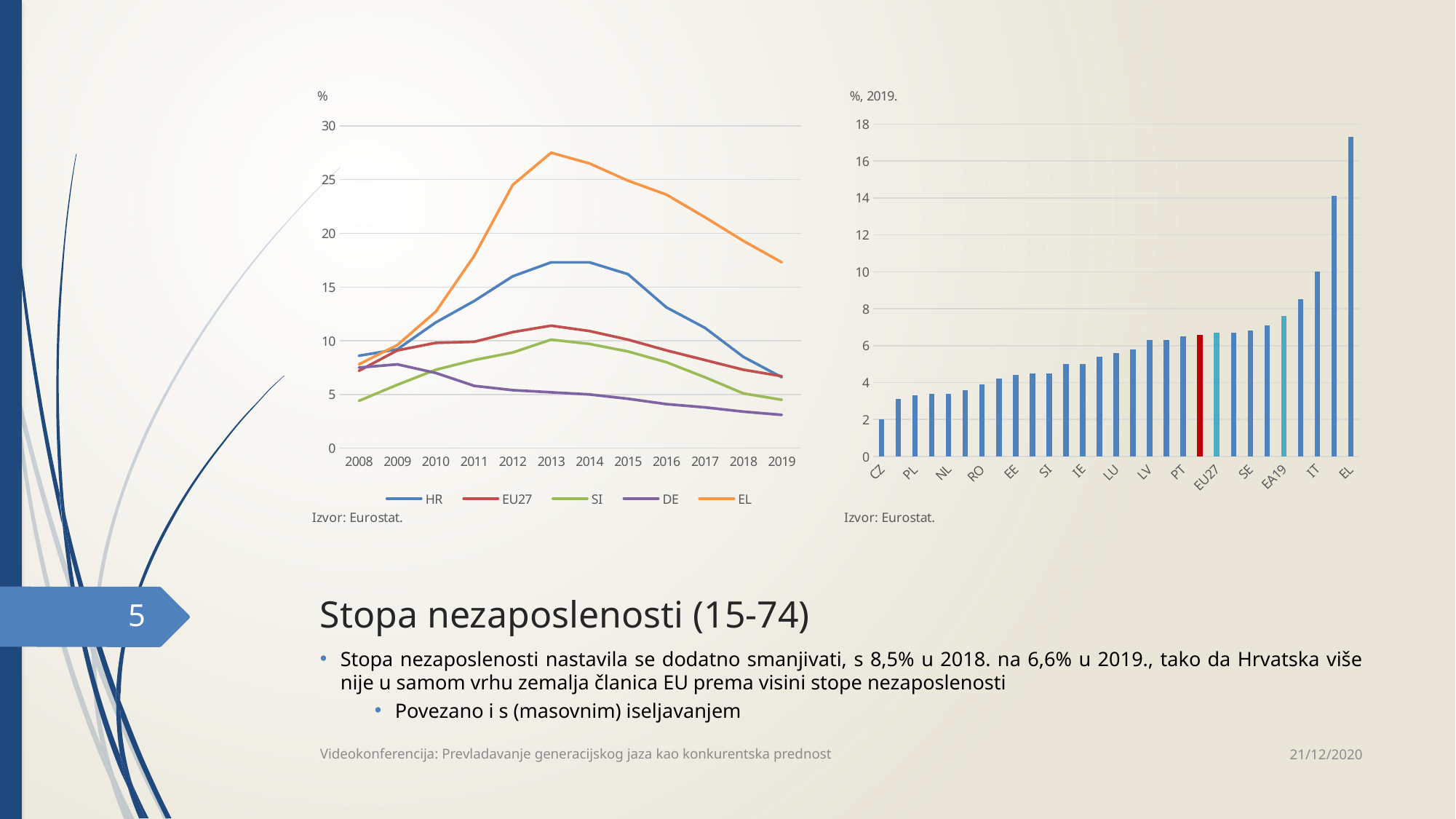
In the line chart on the left, does the HR series rise or fall from 2013 to 2019? fall In the line chart on the left, which is larger in 2013, HR or DE? HR In the bar chart on the right, which country has the lowest bar? CZ In the line chart on the left, how many series does the legend list? 5 In the line chart on the left, which series reaches the highest value in 2013? EL In the bar chart on the right, is the value for EL greater or less than 16? greater In the line chart on the left, is the value for EL in 2013 greater or less than 25? greater In the line chart on the left, how many years are shown on the x axis? 12 In the bar chart on the right, which country has the highest bar? EL What kind of chart is the chart on the right of the slide? bar chart What kind of chart is the chart on the left of the slide? line chart In the line chart on the left, is the value for HR in 2019 greater or less than 10? less